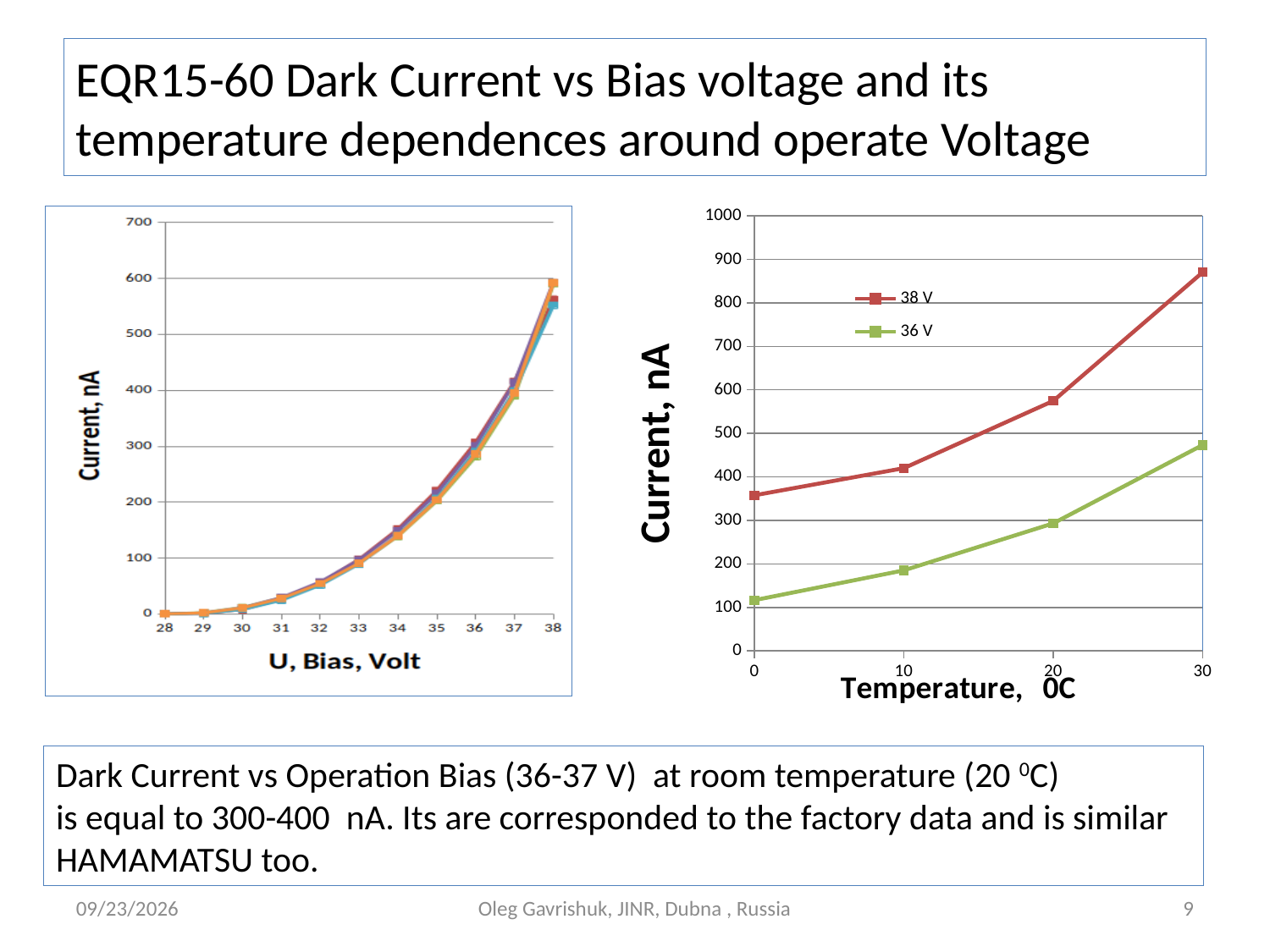
On the left chart (Current vs U, Bias), do the current values rise or fall as the bias voltage increases? rise On the left chart (Current vs U, Bias), are the current values at 38 V greater or less than 500? greater On the right chart (Current vs Temperature), what kind of chart is shown? line chart On the right chart (Current vs Temperature), is the value of the 36 V series at 0 greater or less than 200? less On the right chart (Current vs Temperature), is the value of the 36 V series at 30 greater or less than 400? greater On the right chart (Current vs Temperature), how many series does the legend list? 2 On the right chart (Current vs Temperature), which series has the higher value at 20: 38 V or 36 V? 38 V On the right chart (Current vs Temperature), how many data points does the 36 V series have? 4 On the left chart (Current vs U, Bias), what is the x-axis title? U, Bias, Volt On the right chart (Current vs Temperature), which series does the legend list first? 38 V On the right chart (Current vs Temperature), do the values of the 38 V series rise or fall as temperature increases? rise